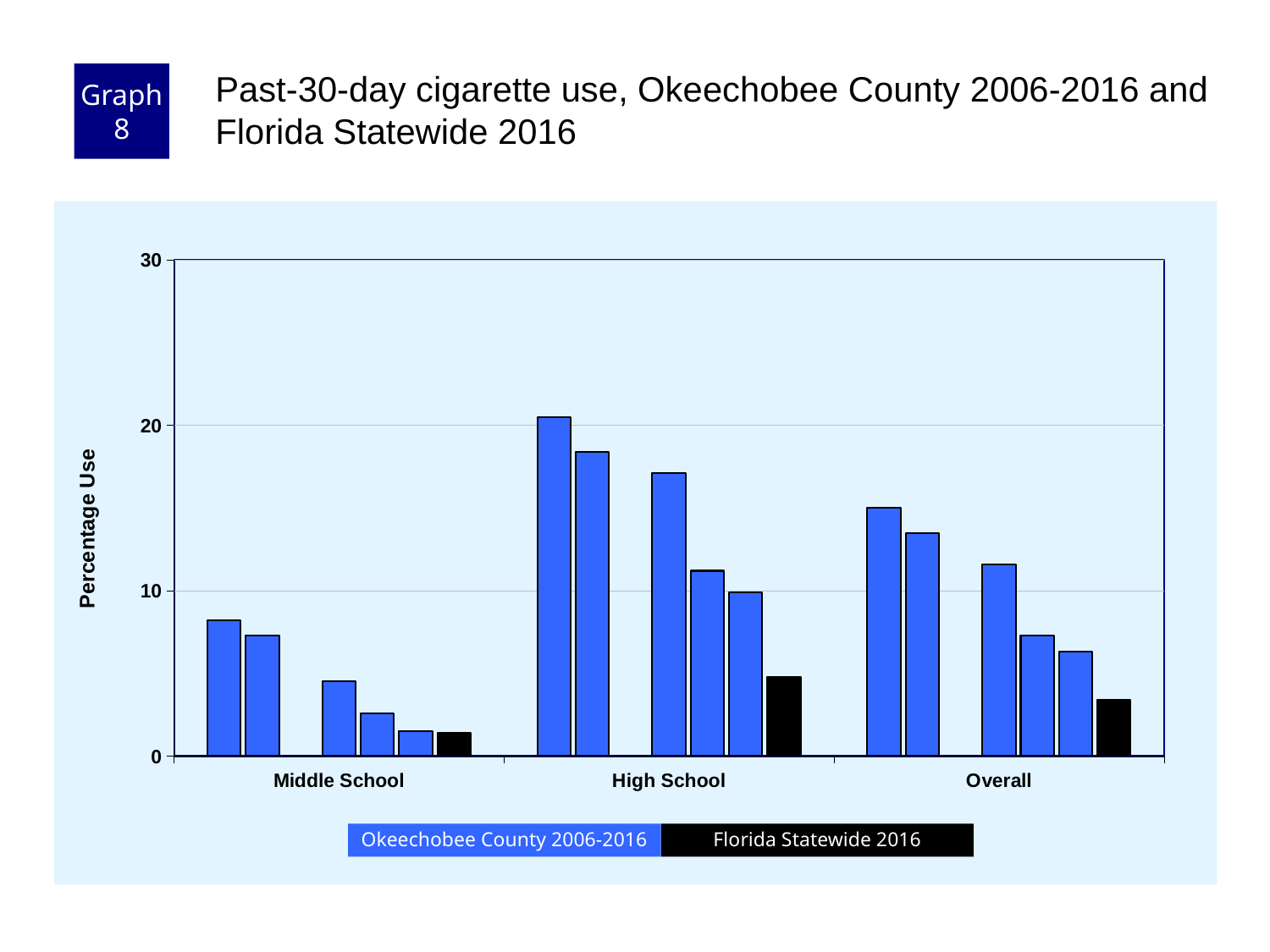
What kind of chart is shown on the slide? bar chart What is the label of the y axis? Percentage Use How many series does the legend list? 2 Is the Florida Statewide 2016 value for High School greater or less than 10? less Which category has the highest bars overall? High School Is the Florida Statewide 2016 value for Middle School greater or less than 10? less Is the tallest Okeechobee County bar in the Overall group greater or less than 20? less Is the Florida Statewide 2016 value larger for High School or for Middle School? High School Which category has the lowest Florida Statewide 2016 value? Middle School How many categories are shown on the x axis? 3 Which colour represents Florida Statewide 2016 in the legend? black